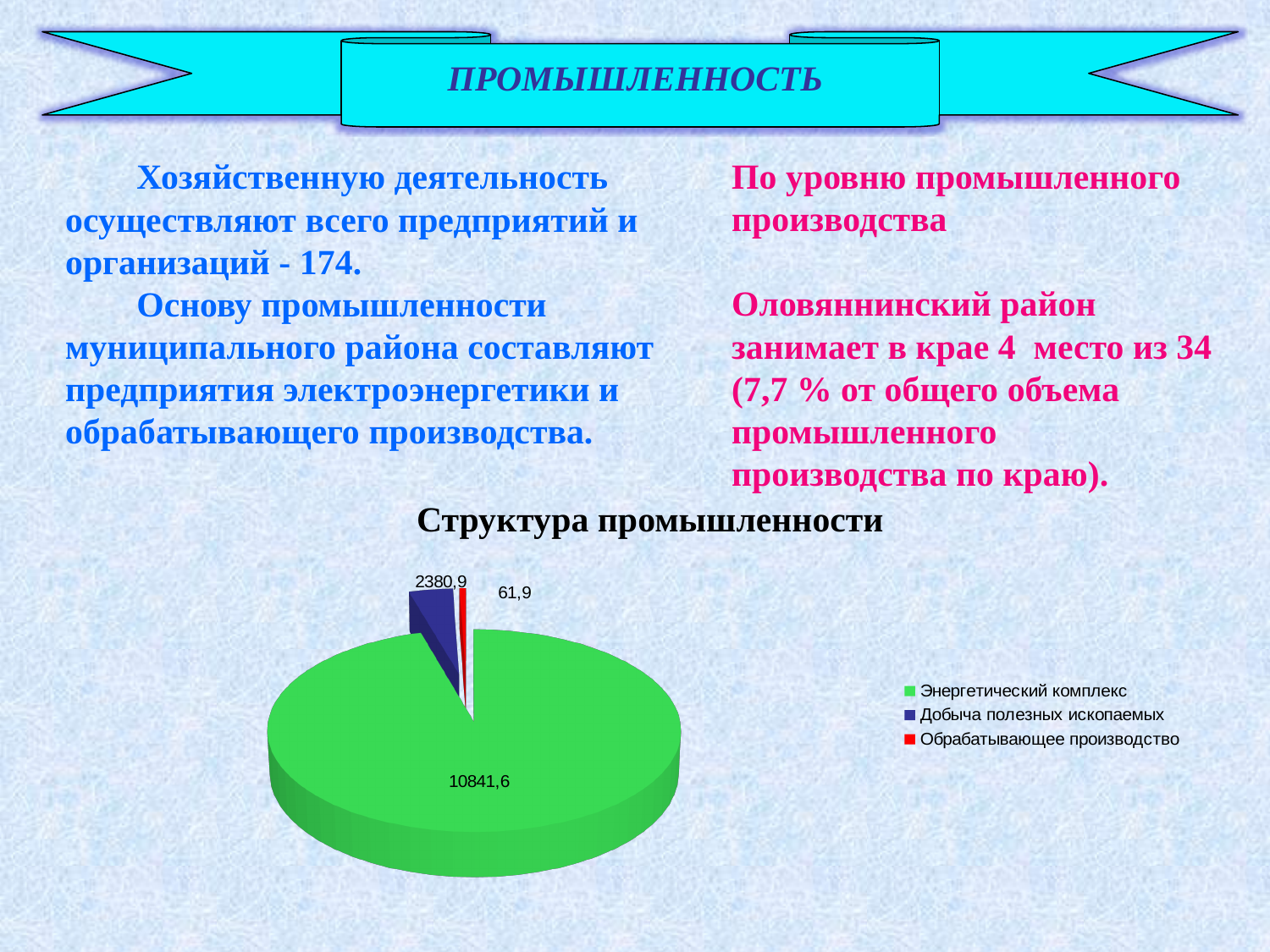
What colour is the slice for Энергетический комплекс in the pie chart? green Which category has the largest slice in the pie chart? Энергетический комплекс Which is larger: the value for Добыча полезных ископаемых or the value for Обрабатывающее производство? Добыча полезных ископаемых What is the difference between the values for Энергетический комплекс and Добыча полезных ископаемых? 8460,7 What is the value for Добыча полезных ископаемых in the pie chart? 2380,9 What is the value for Энергетический комплекс in the pie chart? 10841,6 How many categories does the pie chart show? 3 What is the difference between the values for Добыча полезных ископаемых and Обрабатывающее производство? 2319 What is the value for Обрабатывающее производство in the pie chart? 61,9 What kind of chart is shown under the heading "Структура промышленности"? pie chart What is the total of all three values in the pie chart? 13284,4 Which category has the smallest slice in the pie chart? Обрабатывающее производство